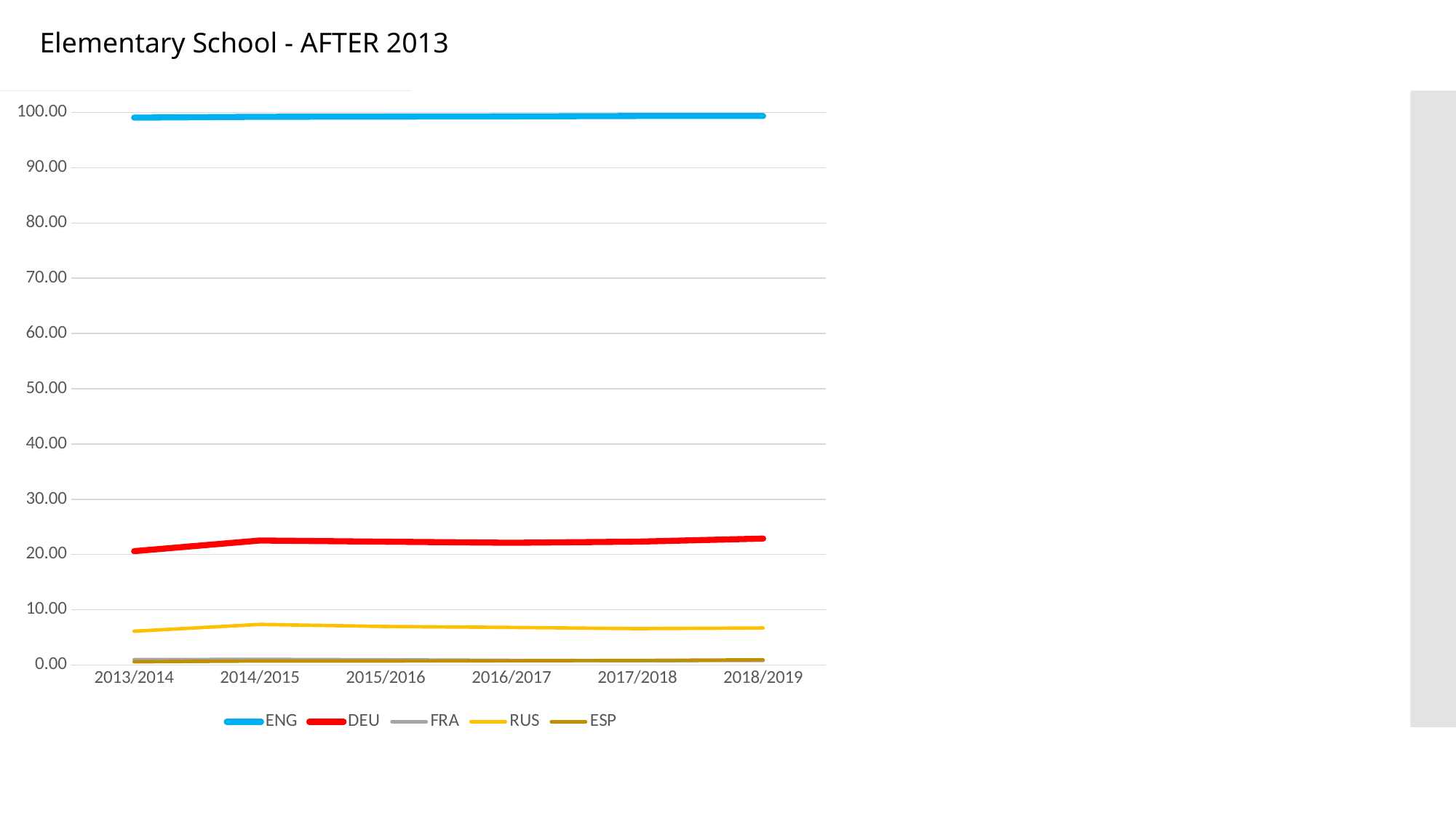
Which is larger in 2016/2017, the value for DEU or the value for RUS? DEU Which series is the second highest on the chart? DEU Is the value for ENG in 2018/2019 greater or less than 90.00? greater What is the title of the slide? Elementary School - AFTER 2013 Which series has the highest values across all years? ENG How many series does the legend list? 5 Is the value for RUS in 2014/2015 greater or less than 10.00? less What is the first school year shown on the x axis? 2013/2014 How many school years are shown on the x axis? 6 Is the value for DEU in 2013/2014 greater or less than 30.00? less What kind of chart is shown on the slide? line chart